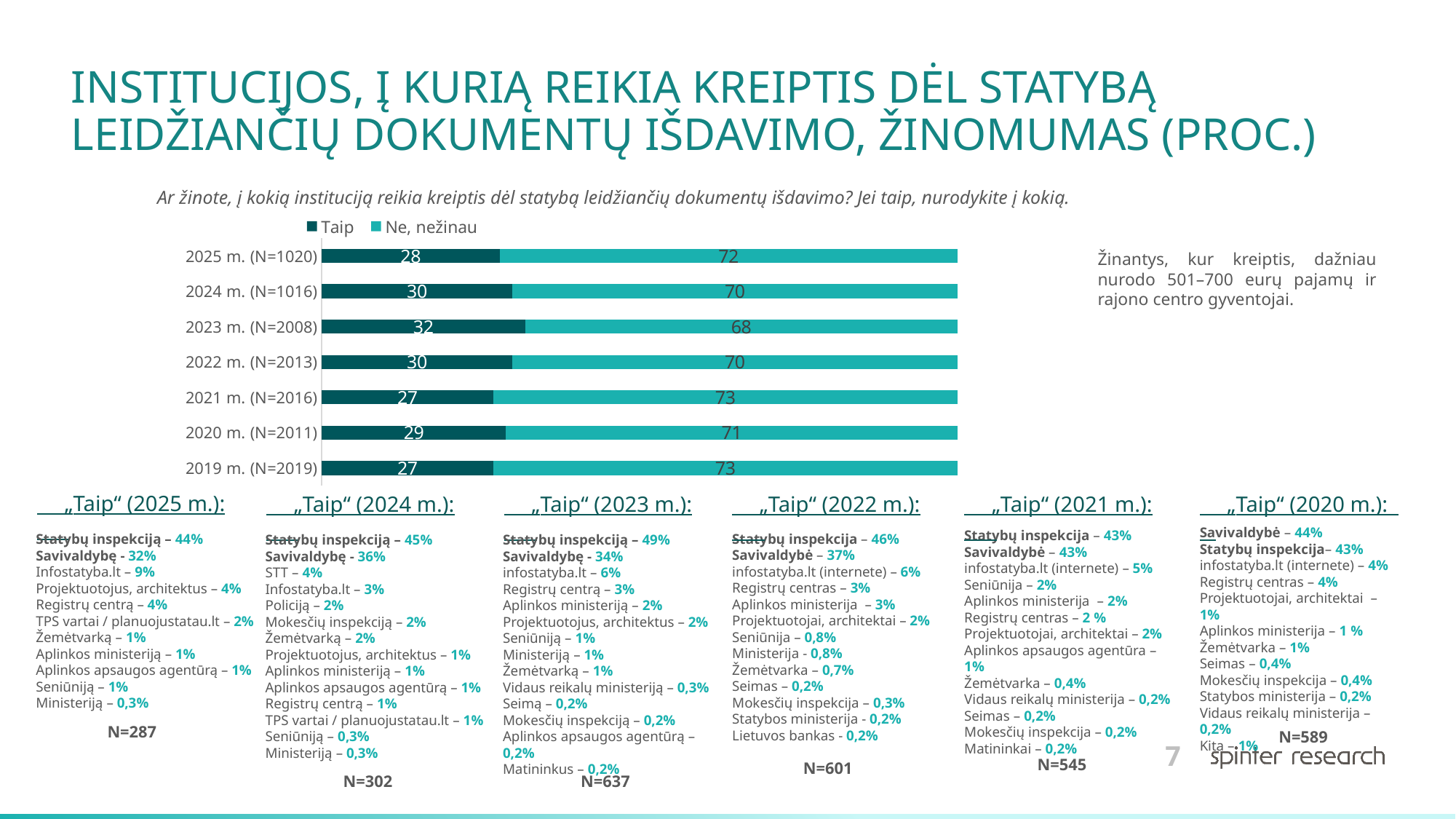
What is the "Taip" value for 2025 m. (N=1020)? 28 What is the "Taip" value for 2020 m. (N=2011)? 29 What kind of chart is shown on the slide? Stacked bar chart What is the difference between the "Ne, nežinau" and "Taip" values for 2021 m. (N=2016)? 46 How many series does the legend list? 2 How many years (categories) are shown in the chart? 7 Which is larger: the "Taip" value for 2024 m. (N=1016) or for 2025 m. (N=1020)? 2024 m. (N=1016) What is the total of the stacked bar for 2022 m. (N=2013)? 100 What is the "Ne, nežinau" value for 2023 m. (N=2008)? 68 Which year has the lowest "Ne, nežinau" value? 2023 m. (N=2008) What are the two legend entries of the chart? Taip; Ne, nežinau Which year has the highest "Taip" value? 2023 m. (N=2008)